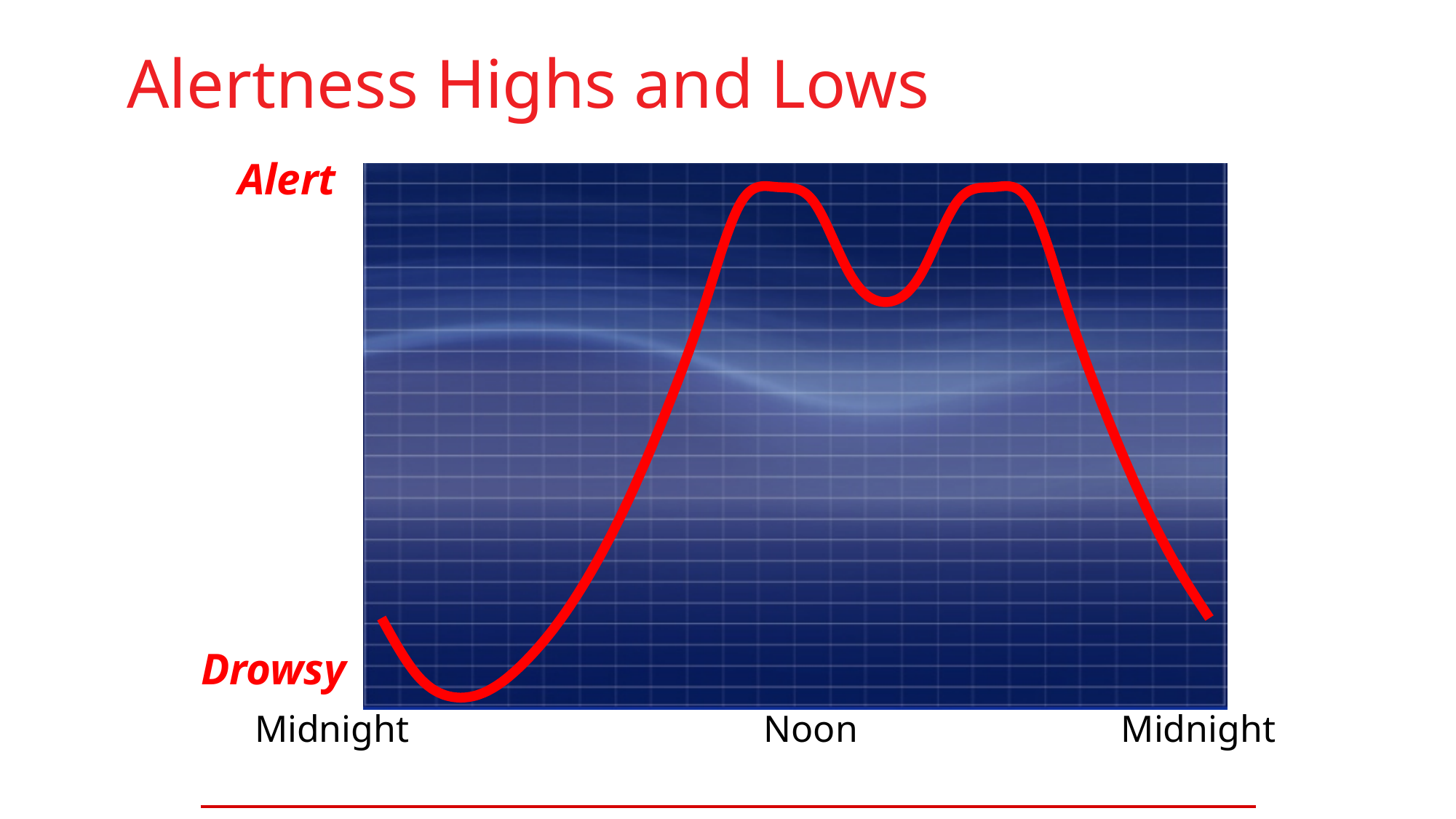
What kind of chart is shown on the slide? line chart Does the line dip or rise shortly after Noon before the second peak? dip Is alertness higher at Noon or at the left-hand Midnight? Noon Is alertness higher at the right-hand Midnight or at Noon? Noon What label appears at the top of the vertical axis? Alert How many labels are shown along the horizontal axis? 3 Does the line rise or fall between the second peak and Midnight on the right? fall Does the line rise or fall between Midnight (left) and Noon? rise How many peaks does the red line reach near the Alert level? 2 What is the title of the chart on the slide? Alertness Highs and Lows